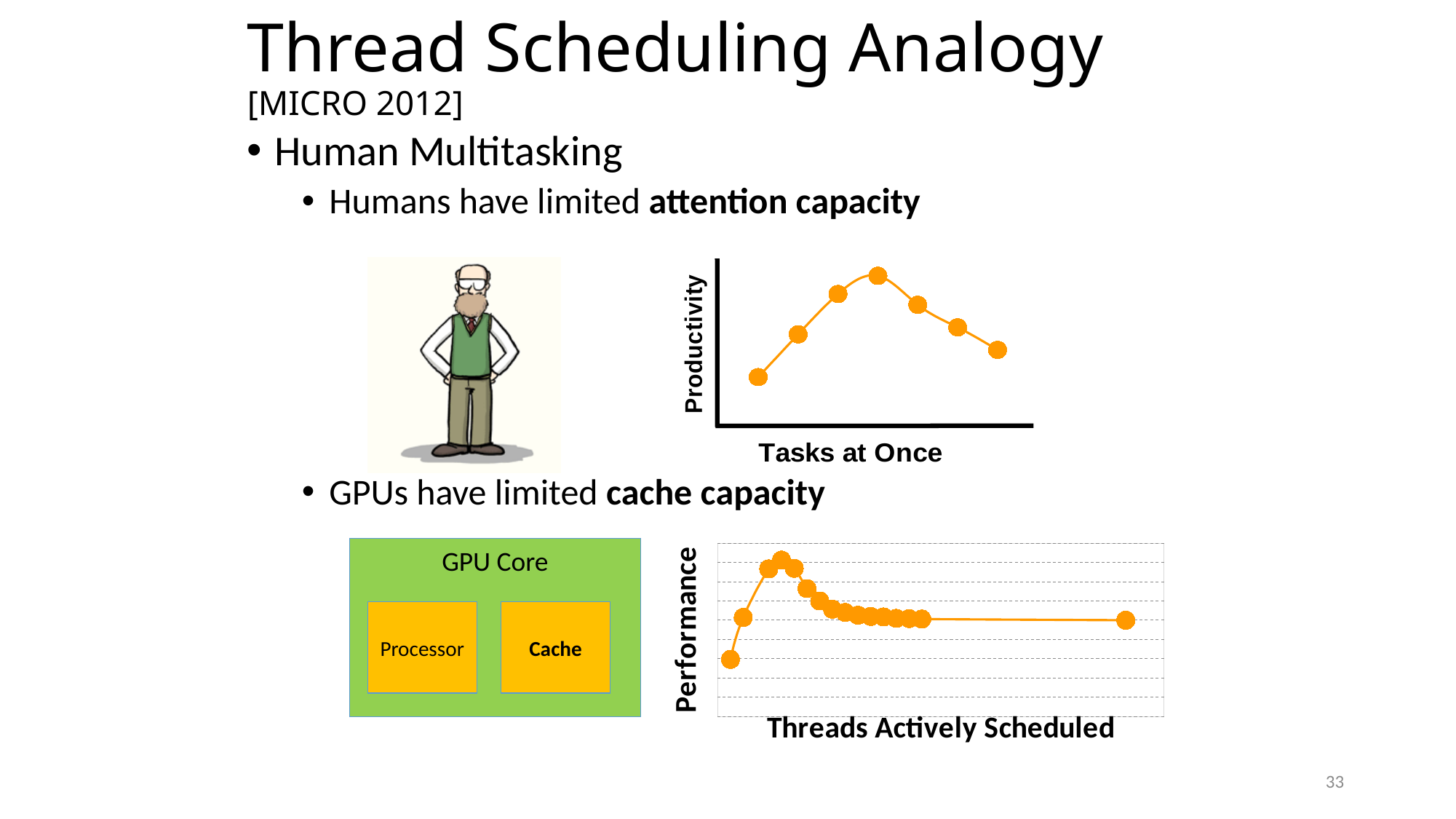
In the top chart (Productivity vs Tasks at Once), which is larger, the productivity at the first point or at the last point? the last point What is the x axis label of the bottom chart? Threads Actively Scheduled In the top chart (Productivity vs Tasks at Once), how does productivity change as the number of tasks at once increases? rises to a peak, then falls What is the y axis label of the top chart? Productivity What kind of chart is the top chart with the x axis labelled 'Tasks at Once'? line chart In the top chart (Productivity vs Tasks at Once), which point has the lowest productivity: the first or the last? the first In the bottom chart (Performance vs Threads Actively Scheduled), how does performance change as more threads are actively scheduled? rises sharply to a peak, then falls and levels off In the top chart (Productivity vs Tasks at Once), which point is the highest: the first, the fourth, or the last? the fourth In the bottom chart (Performance vs Threads Actively Scheduled), which point has the lowest performance: the first or the last? the first In the top chart (Productivity vs Tasks at Once), how many data points are plotted? 7 In the bottom chart (Performance vs Threads Actively Scheduled), which is larger, the performance at the first point or at the last point? the last point What kind of chart is the bottom chart with the x axis labelled 'Threads Actively Scheduled'? line chart